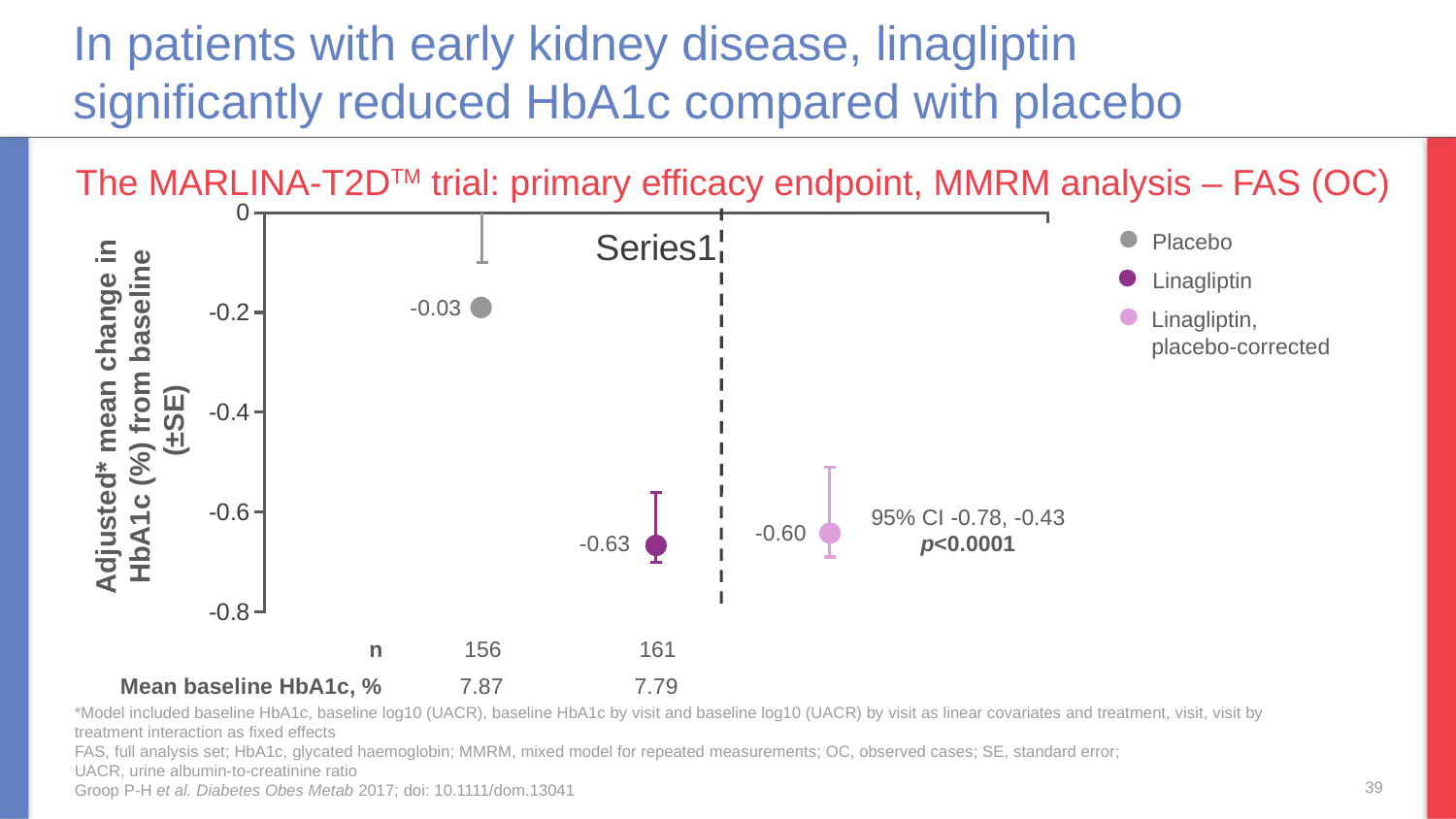
Which group shows the lowest (most negative) adjusted mean change in HbA1c? Linagliptin What is the mean baseline HbA1c, %, for the Linagliptin group? 7.79 How many entries does the legend list? 3 What is the n for the Placebo group shown below the chart? 156 What is the difference between the Linagliptin value (-0.63) and the Placebo value (-0.03)? 0.60 What is the adjusted mean change in HbA1c from baseline for Linagliptin? -0.63 What is the placebo-corrected adjusted mean change in HbA1c for Linagliptin? -0.60 Is the value for Linagliptin greater or less than -0.4? less What kind of chart is shown on the slide? Scatter (dot) plot with error bars What is the adjusted mean change in HbA1c from baseline for Placebo? -0.03 What 95% CI is shown for the placebo-corrected Linagliptin value? -0.78, -0.43 Which shows a larger reduction in HbA1c from baseline, Placebo or Linagliptin? Linagliptin